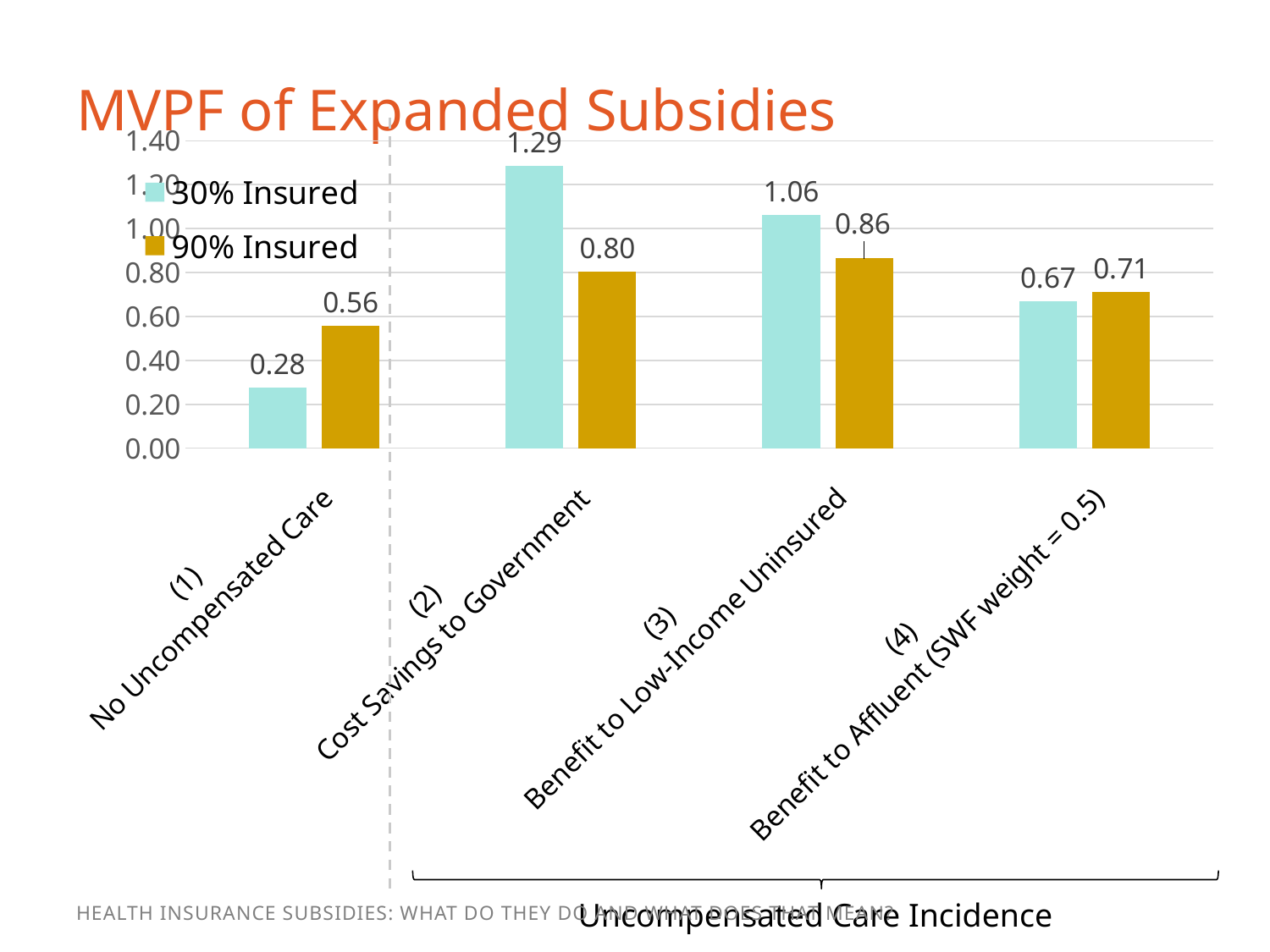
How many series does the legend list? 2 What is the title of the chart? MVPF of Expanded Subsidies What is the MVPF for the 90% Insured series under (3) Benefit to Low-Income Uninsured? 0.86 How many categories are shown on the x axis? 4 What is the MVPF for the 90% Insured series under (1) No Uncompensated Care? 0.56 What is the difference between the 30% Insured and 90% Insured values under (2) Cost Savings to Government? 0.49 Which category has the lowest value for the 90% Insured series? (1) No Uncompensated Care Which category has the highest value for the 30% Insured series? (2) Cost Savings to Government What is the MVPF for the 30% Insured series under (2) Cost Savings to Government? 1.29 Is the 30% Insured value under (3) Benefit to Low-Income Uninsured greater or less than 1.00? greater What kind of chart is shown on the slide? bar chart Under (4) Benefit to Affluent (SWF weight = 0.5), which series has the larger value, 30% Insured or 90% Insured? 90% Insured